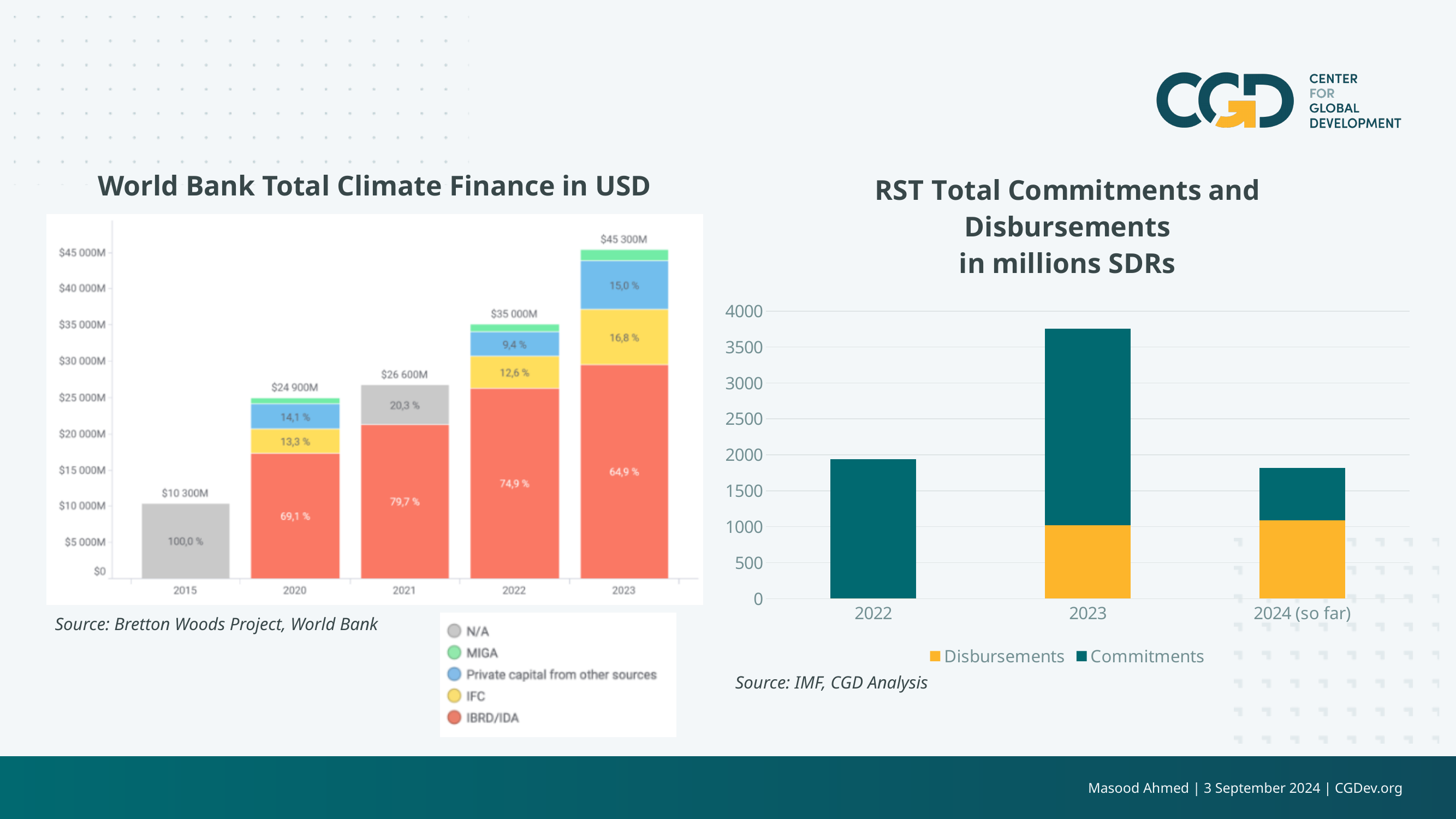
In the World Bank Total Climate Finance in USD chart, how many years are shown on the x axis? 5 In the World Bank Total Climate Finance in USD chart, what percentage share does IFC have in 2020? 13,3 % In the World Bank Total Climate Finance in USD chart, what is the difference between the 2023 total and the 2022 total? $10 300M In the World Bank Total Climate Finance in USD chart, what percentage share does IBRD/IDA have in 2022? 74,9 % In the World Bank Total Climate Finance in USD chart, do the total values rise or fall from 2015 to 2023? rise In the World Bank Total Climate Finance in USD chart, what is the total value labelled for 2023? $45 300M In the World Bank Total Climate Finance in USD chart, which year has the highest total climate finance? 2023 In the RST Total Commitments and Disbursements chart, is the total for 2023 greater or less than 3500? greater In the World Bank Total Climate Finance in USD chart, what is the total value labelled for 2015? $10 300M In the World Bank Total Climate Finance in USD chart, how many series does the legend list? 5 In the RST Total Commitments and Disbursements chart, which year has the highest total bar? 2023